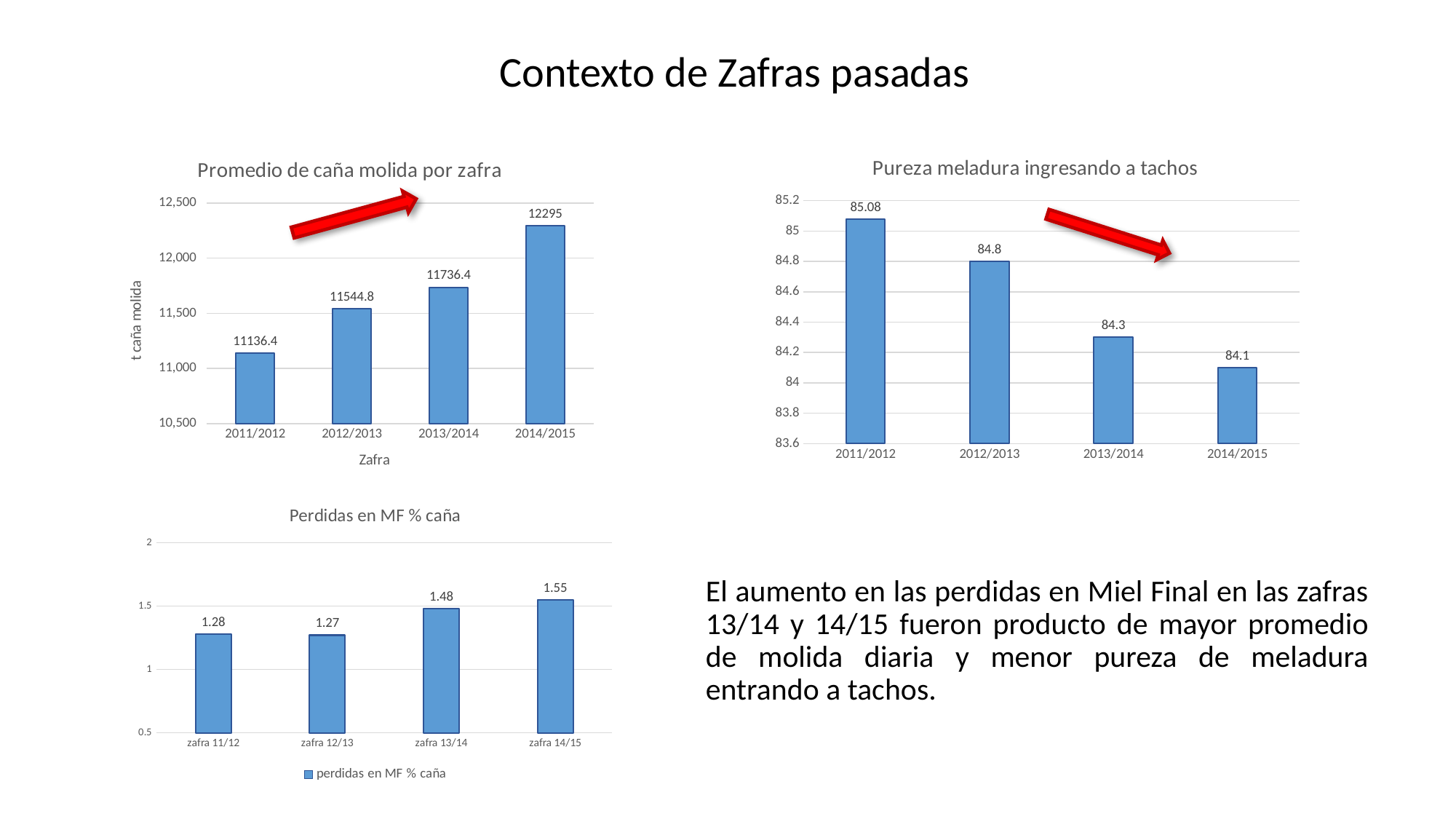
What kind of chart is 'Perdidas en MF % caña'? bar chart In the chart 'Pureza meladura ingresando a tachos', what is the value for 2011/2012? 85.08 In the chart 'Perdidas en MF % caña', what is the value for zafra 14/15? 1.55 In the chart 'Pureza meladura ingresando a tachos', which zafra has the lowest value? 2014/2015 In the chart 'Promedio de caña molida por zafra', which zafra has the lowest value? 2011/2012 In the chart 'Pureza meladura ingresando a tachos', do the values rise or fall from 2011/2012 to 2014/2015? fall In the chart 'Perdidas en MF % caña', what is the difference between the values for zafra 13/14 and zafra 11/12? 0.2 In the chart 'Promedio de caña molida por zafra', do the values rise or fall from 2011/2012 to 2014/2015? rise In the chart 'Promedio de caña molida por zafra', what is the value for 2014/2015? 12295 In the chart 'Promedio de caña molida por zafra', what is the difference between the values for 2013/2014 and 2012/2013? 191.6 In the chart 'Perdidas en MF % caña', which zafra has the highest value? zafra 14/15 In the chart 'Pureza meladura ingresando a tachos', how many zafras are shown on the x axis? 4